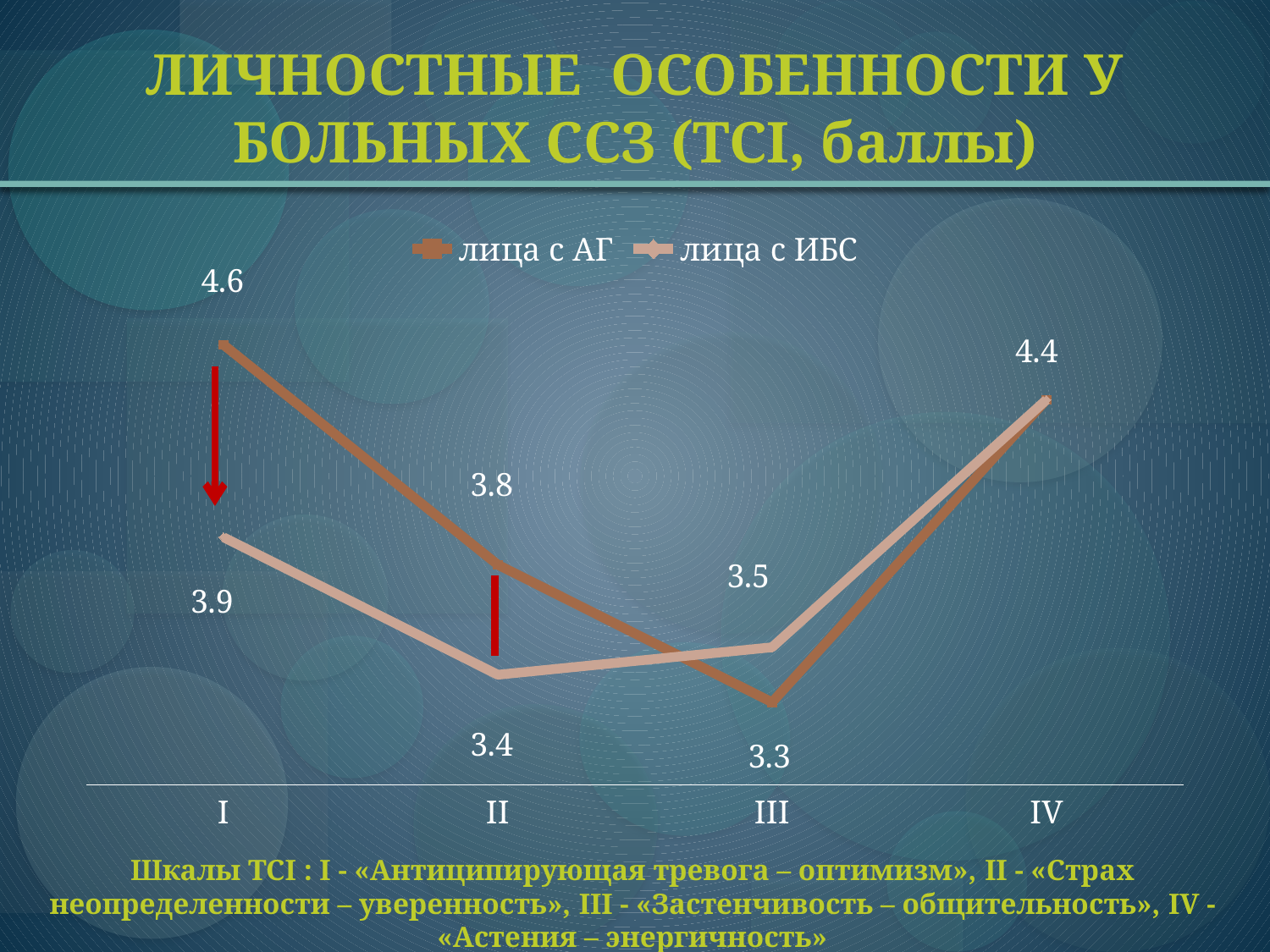
How many series does the legend list? 2 What is the value for scale III for the series 'лица с ИБС'? 3.5 What is the value for scale II for the series 'лица с ИБС'? 3.4 What is the value for scale I for the series 'лица с АГ'? 4.6 What is the value for scale I for the series 'лица с ИБС'? 3.9 For the series 'лица с АГ', which scale has the lowest value? III At scale III, which series has the larger value, 'лица с АГ' or 'лица с ИБС'? лица с ИБС What is the value for scale III for the series 'лица с АГ'? 3.3 What is the difference between the 'лица с АГ' and 'лица с ИБС' values at scale I? 0.7 What kind of chart is shown on the slide? line chart What is the value for scale II for the series 'лица с АГ'? 3.8 How many categories are shown on the x axis? 4